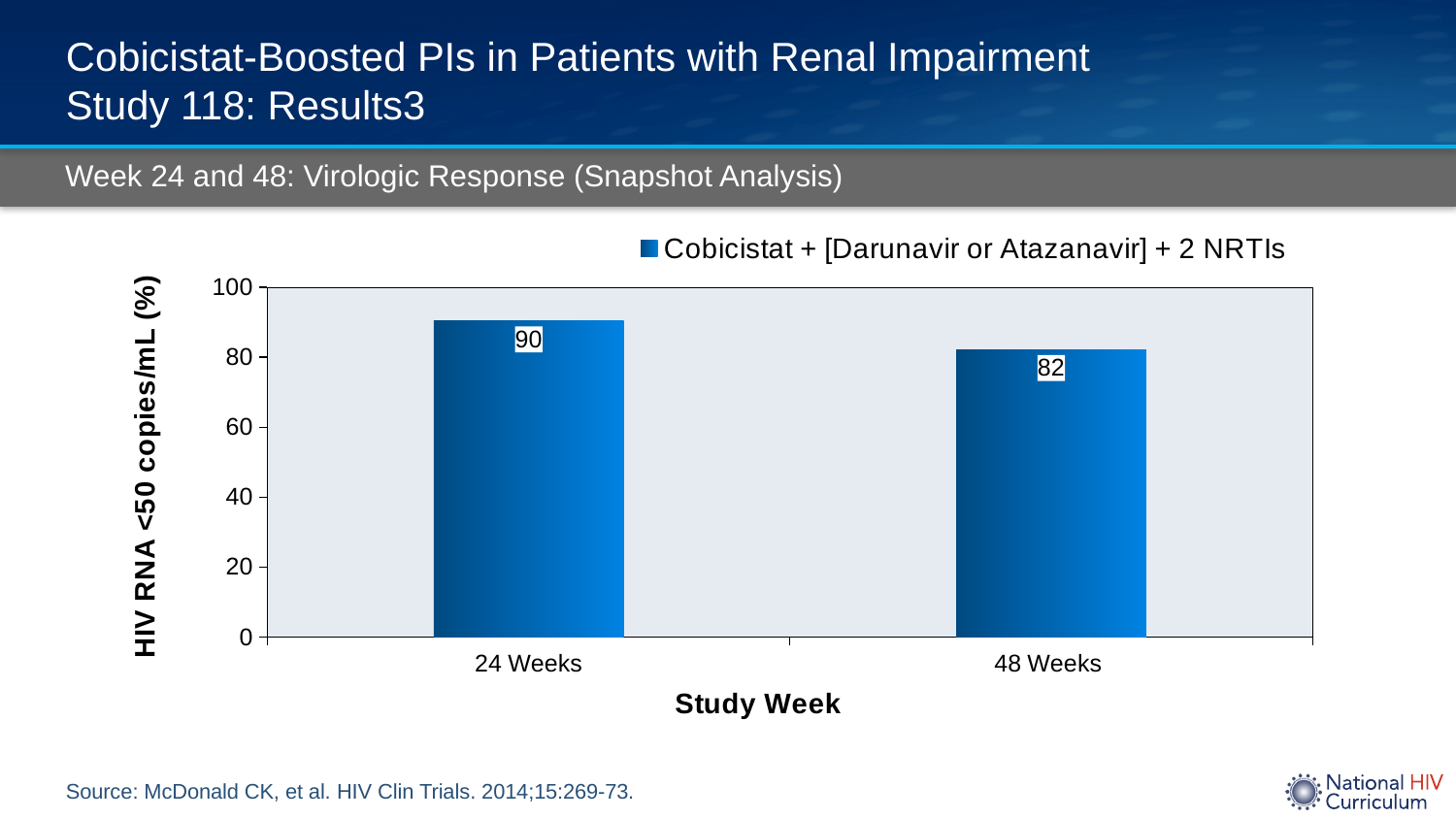
What is the value for 24 Weeks? 90 What is the label of the y axis? HIV RNA <50 copies/mL (%) Which study week has the lowest value? 48 Weeks Is the value for 48 Weeks greater or less than 60? greater Which is larger, the value for 24 Weeks or the value for 48 Weeks? 24 Weeks What is the difference between the values for 24 Weeks and 48 Weeks? 8 How many study week categories are shown on the x axis? 2 What is the value for 48 Weeks? 82 Do the values rise or fall from 24 Weeks to 48 Weeks? fall What kind of chart is shown on the slide? bar chart How many series does the legend list? 1 Which study week has the highest value? 24 Weeks